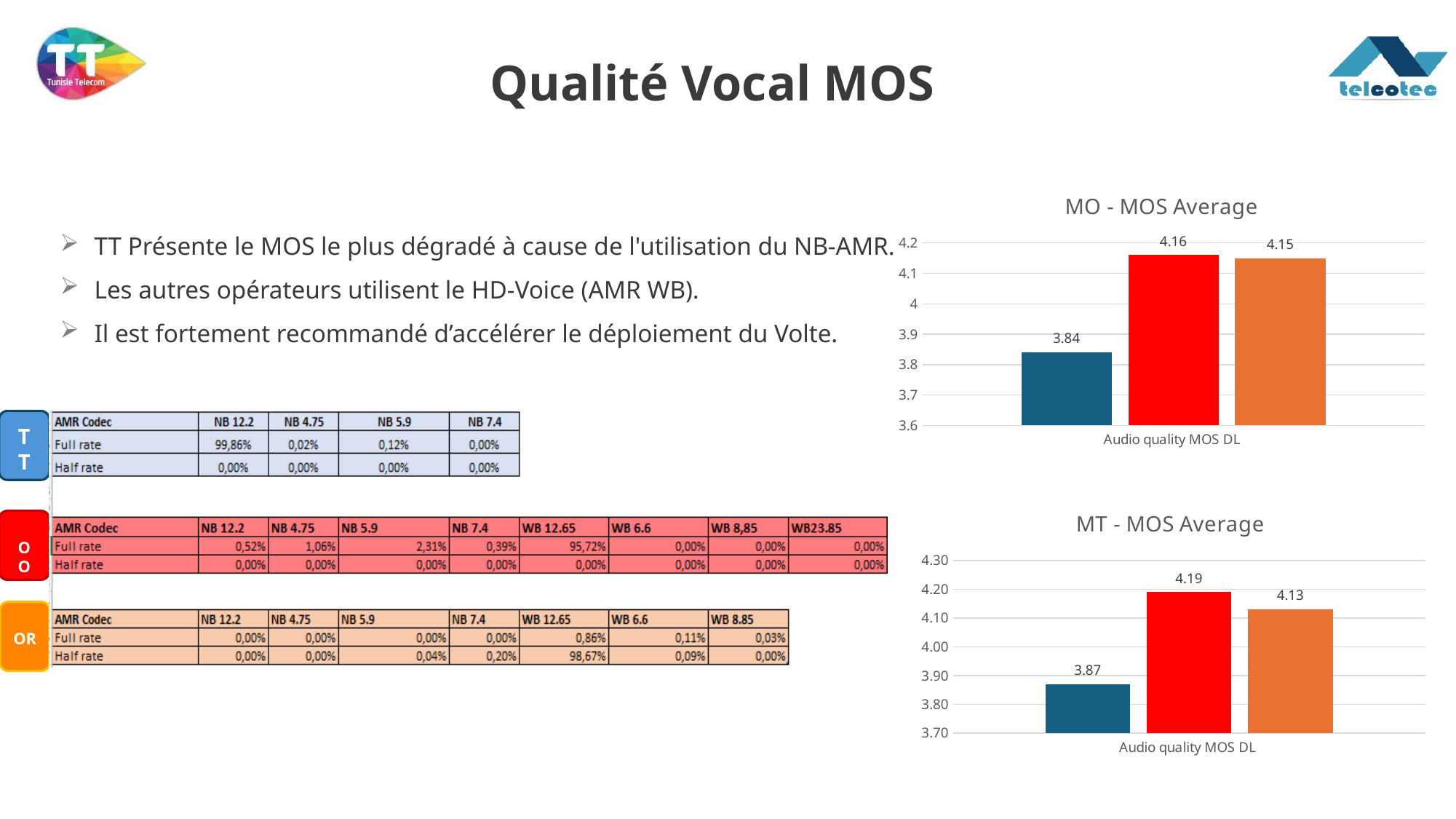
How many bars are plotted in the MT - MOS Average chart? 3 In the MT - MOS Average chart, what is the value of the blue bar? 3.87 What type of chart is the MO - MOS Average chart? bar chart In the MO - MOS Average chart, is the value of the blue bar greater or less than 4? less In the MO - MOS Average chart, which bar has the lowest value? the blue bar (3.84) In the MO - MOS Average chart, what is the value of the red bar? 4.16 In the MT - MOS Average chart, what is the difference between the red bar and the orange bar? 0.06 In the MT - MOS Average chart, what is the value of the orange bar? 4.13 In the MO - MOS Average chart, what is the difference between the red bar and the blue bar? 0.32 In the MO - MOS Average chart, what is the value of the blue bar? 3.84 In the MT - MOS Average chart, which bar has the highest value? the red bar (4.19) In the MT - MOS Average chart, is the blue bar or the orange bar larger? the orange bar